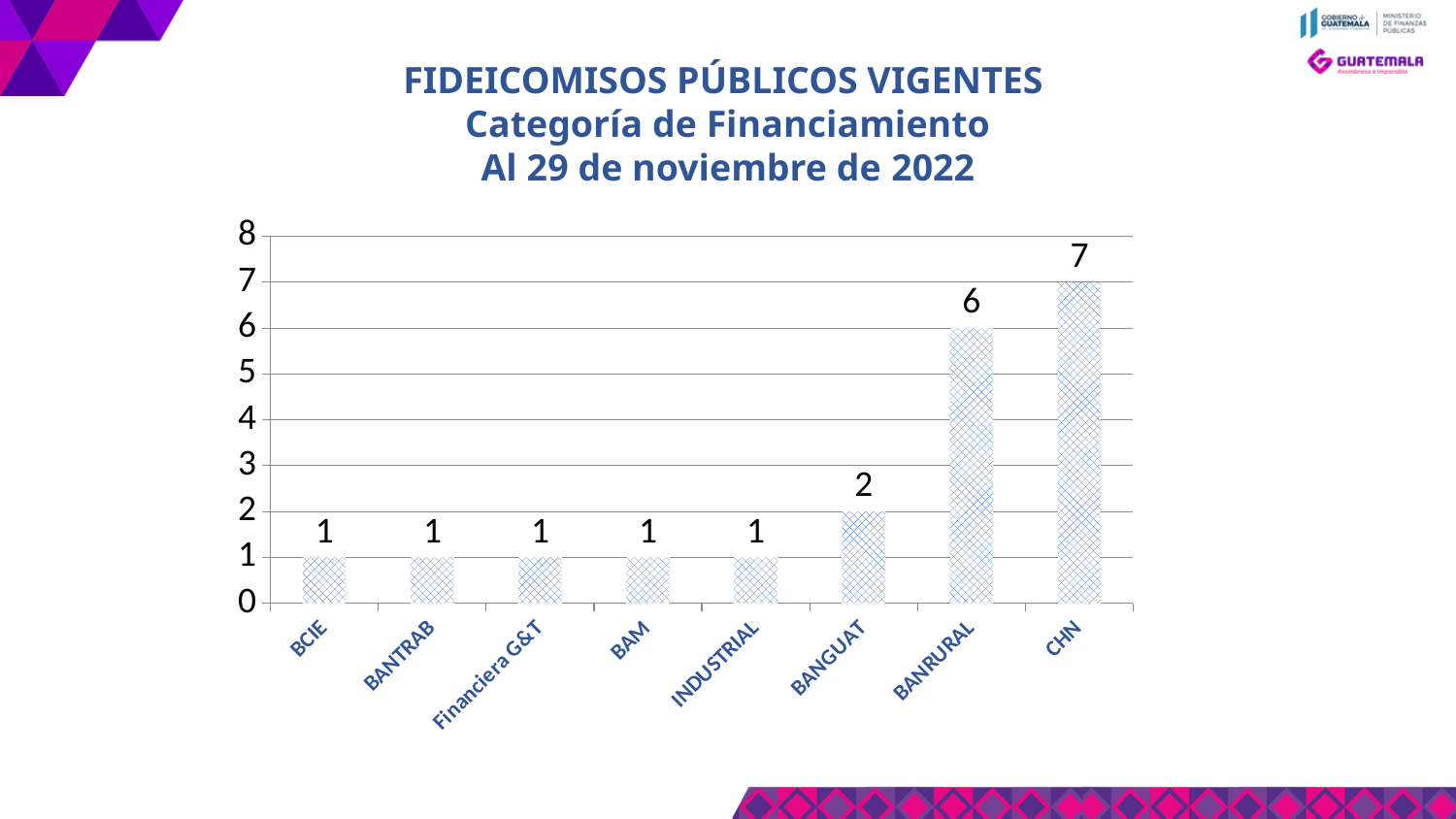
What kind of chart is shown on the slide? bar chart What is the value for BANGUAT? 2 What is the date given in the chart title? 29 de noviembre de 2022 Which is larger, the value for BANGUAT or the value for BAM? BANGUAT Which category has the highest value? CHN What is the value for Financiera G&T? 1 What is the value for CHN? 7 Is the value for BANRURAL greater or less than 4? greater What is the value for BANRURAL? 6 How many categories are shown on the x axis? 8 What is the difference between the values for BANRURAL and BANGUAT? 4 What is the difference between the values for CHN and BANRURAL? 1